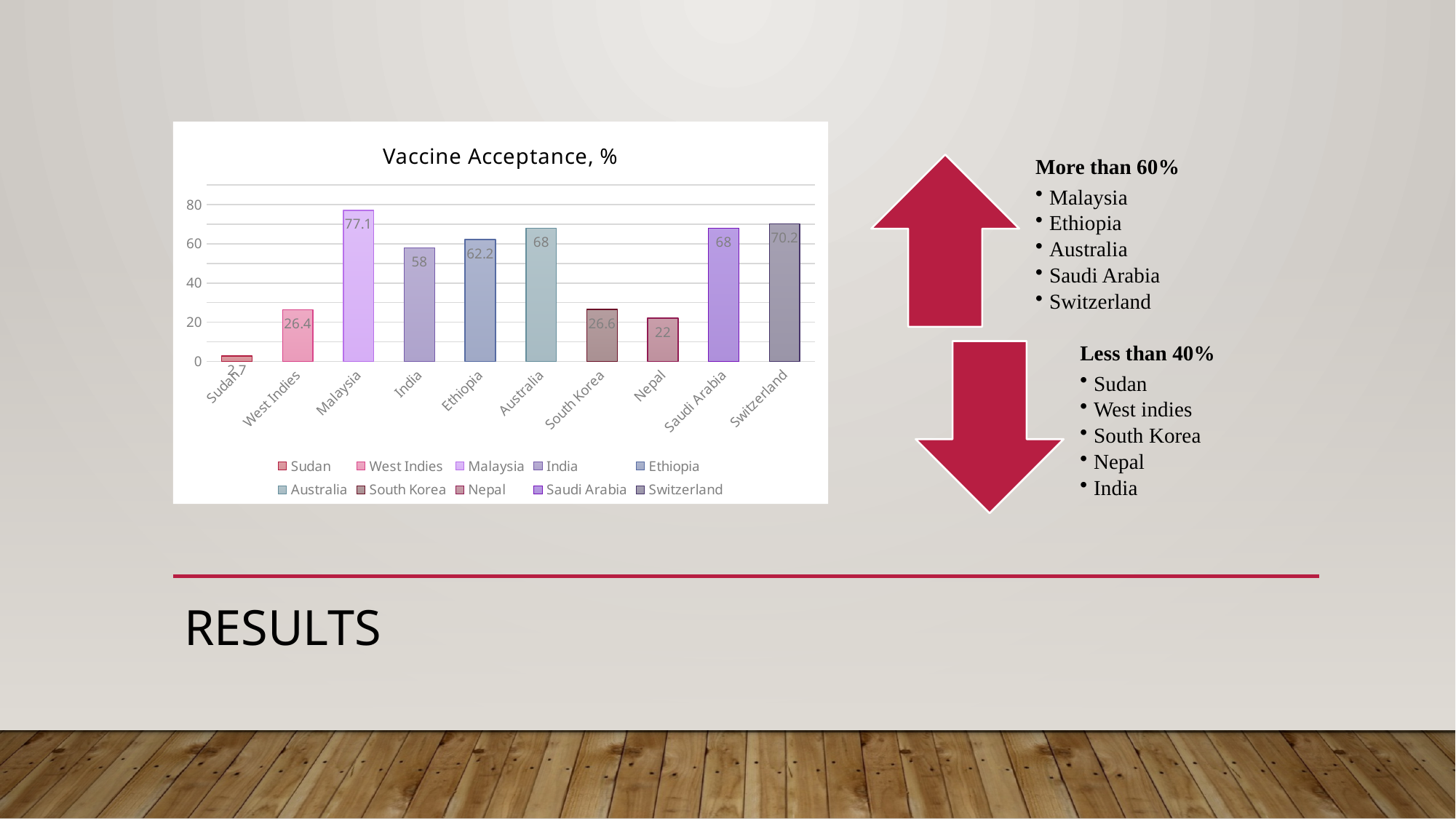
What is the vaccine acceptance value for India? 58 What is the title of the chart? Vaccine Acceptance, % What is the vaccine acceptance value for Malaysia? 77.1 What is the vaccine acceptance value for Nepal? 22 What is the vaccine acceptance value for Switzerland? 70.2 What is the difference between the vaccine acceptance values for Australia and Nepal? 46 Which country has the highest vaccine acceptance? Malaysia Which country has the lowest vaccine acceptance? Sudan What kind of chart is shown on the slide? Bar chart What is the difference between the vaccine acceptance values for Malaysia and Switzerland? 6.9 Which has a higher vaccine acceptance value, Ethiopia or India? Ethiopia How many countries are shown in the chart? 10